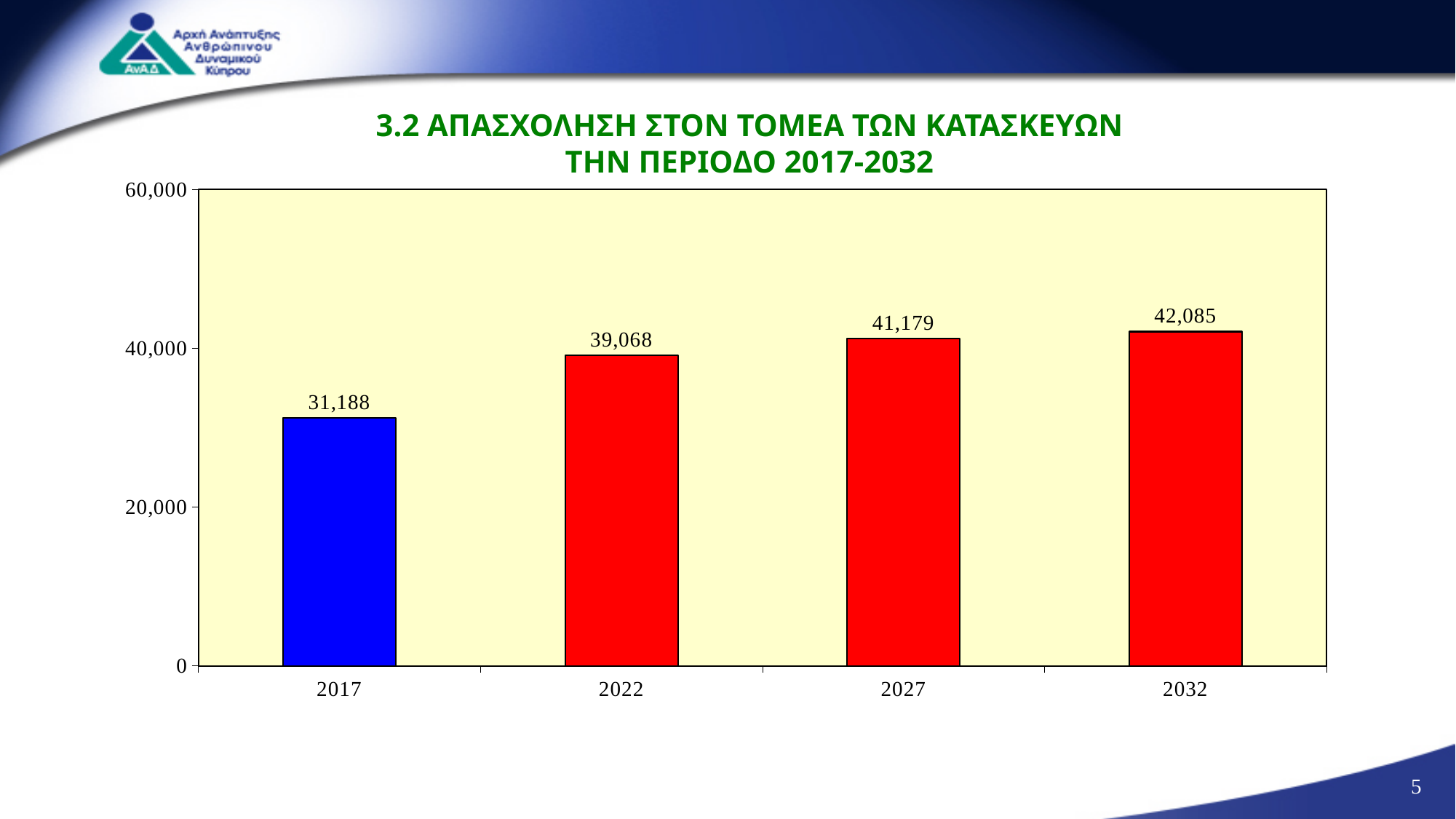
What is the difference between the values for 2032 and 2017? 10,897 What kind of chart is shown on the slide? bar chart What is the value for 2032? 42,085 Do the values rise or fall from 2017 to 2032? rise Is the value for 2017 greater or less than 40,000? less Which year has the highest value? 2032 What is the value for 2027? 41,179 Which year has the lowest value? 2017 What is the value for 2022? 39,068 How many years are shown on the x axis? 4 What is the value for 2017? 31,188 Which is larger, the value for 2022 or the value for 2027? 2027